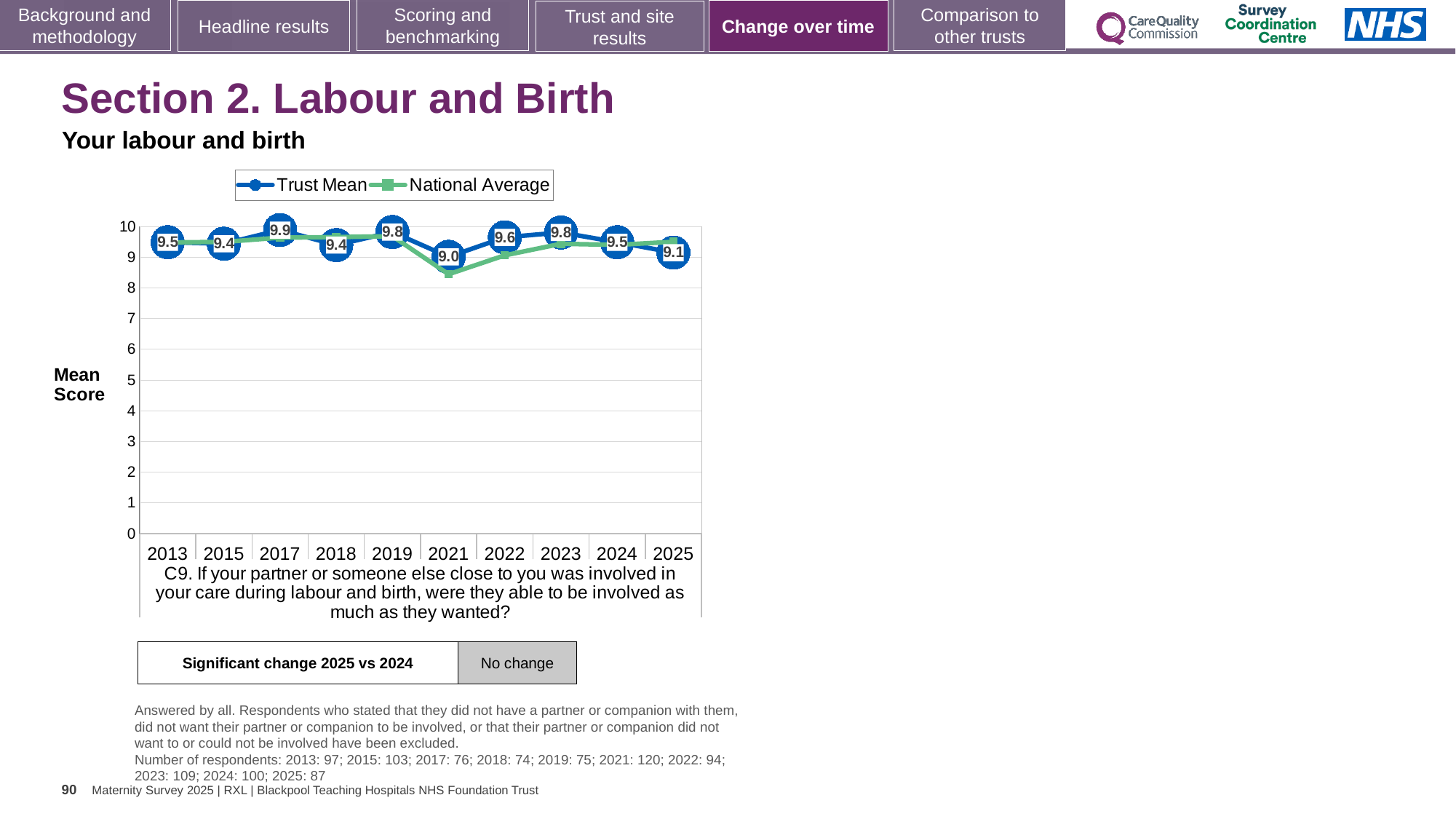
In which year is the Trust Mean lowest? 2021 What is the Trust Mean value for 2017? 9.9 How many years are plotted on the x axis? 10 How many series does the legend list? 2 What is the Trust Mean value for 2025? 9.1 What is the Trust Mean value for 2021? 9.0 Is the National Average value for 2021 greater or less than 9? less Which year has the larger Trust Mean, 2019 or 2021? 2019 In which year is the Trust Mean highest? 2017 What is the difference between the Trust Mean in 2024 and in 2025? 0.4 What is the difference between the Trust Mean in 2017 and in 2021? 0.9 What kind of chart is shown on the slide? line chart